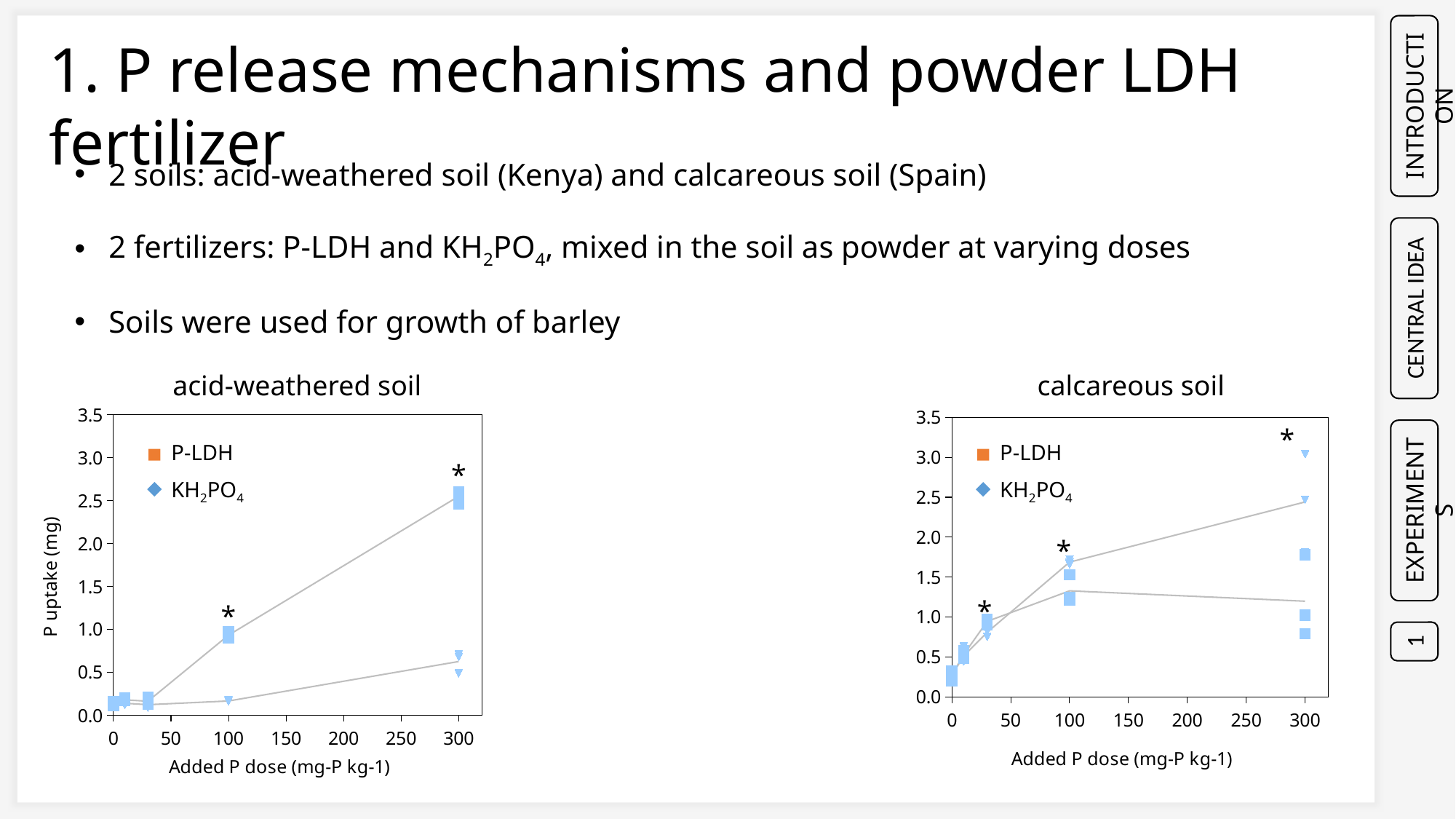
How many series does the legend of the calcareous soil chart list? 2 In the calcareous soil chart, is the P uptake for KH2PO4 at a dose of 100 greater or less than 1.0? greater In the acid-weathered soil chart, is the P uptake for P-LDH at a dose of 300 greater or less than 2.0? greater What kind of chart is the acid-weathered soil chart? scatter chart In the acid-weathered soil chart, does the P uptake for P-LDH rise or fall as the added P dose increases? rise In the acid-weathered soil chart, which series has the higher P uptake at a dose of 300: P-LDH or KH2PO4? P-LDH In the calcareous soil chart, which series has the higher P uptake at a dose of 300: P-LDH or KH2PO4? KH2PO4 What are the two series named in the legend of the acid-weathered soil chart? P-LDH and KH2PO4 In the acid-weathered soil chart, is the P uptake for P-LDH at a dose of 100 greater or less than 0.5? greater